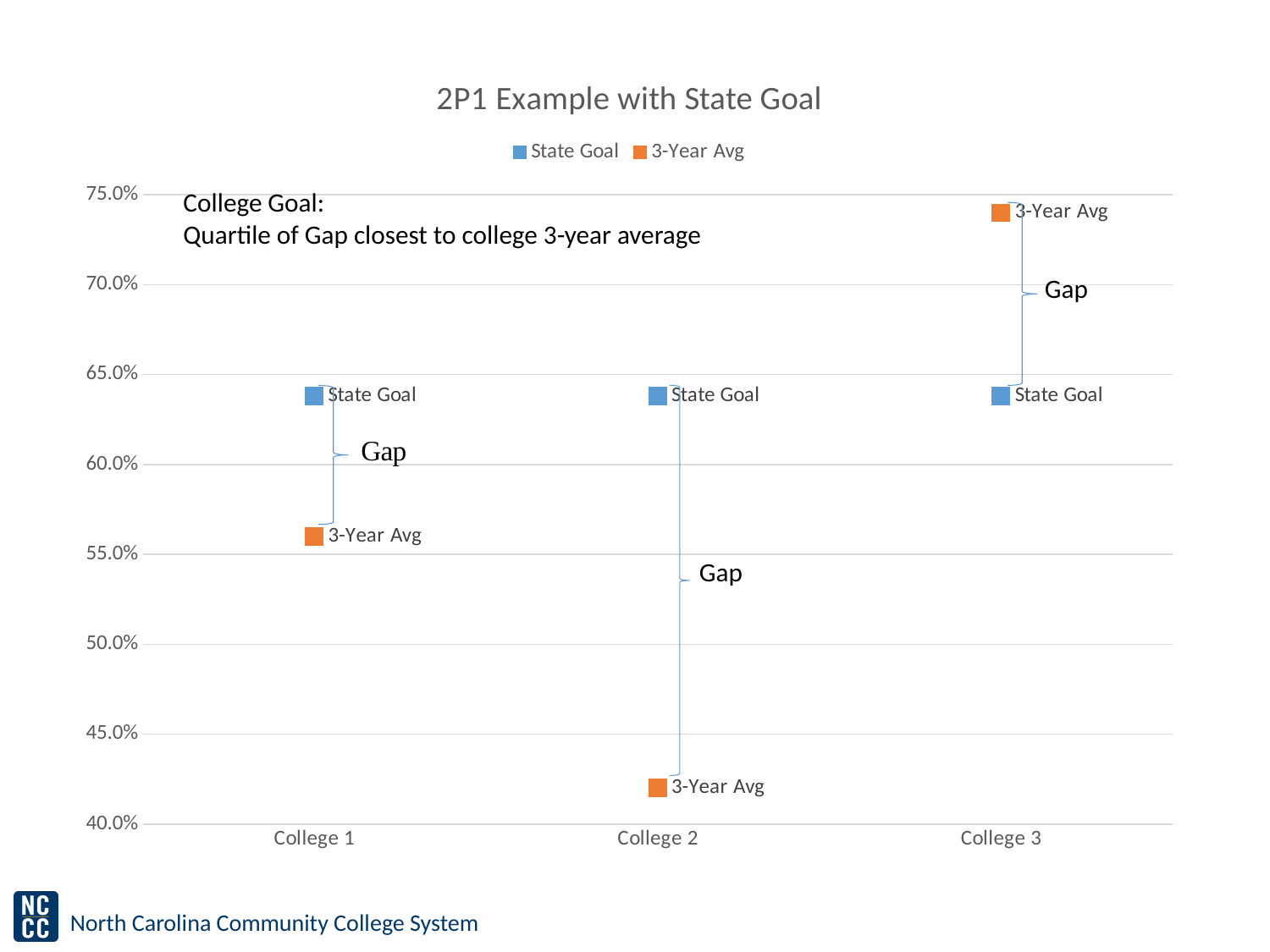
For College 1, which is larger: the State Goal or the 3-Year Avg? State Goal Is the State Goal for College 1 greater or less than 65.0%? less Which series is shown in orange in the legend? 3-Year Avg Which college has the lowest 3-Year Avg? College 2 Is the 3-Year Avg for College 2 greater or less than 45.0%? less What is the title of the chart? 2P1 Example with State Goal How many series does the legend list? 2 Is the 3-Year Avg for College 3 greater or less than 70.0%? greater Which college has the highest 3-Year Avg? College 3 How many colleges are shown on the x axis? 3 For College 3, which is larger: the State Goal or the 3-Year Avg? 3-Year Avg